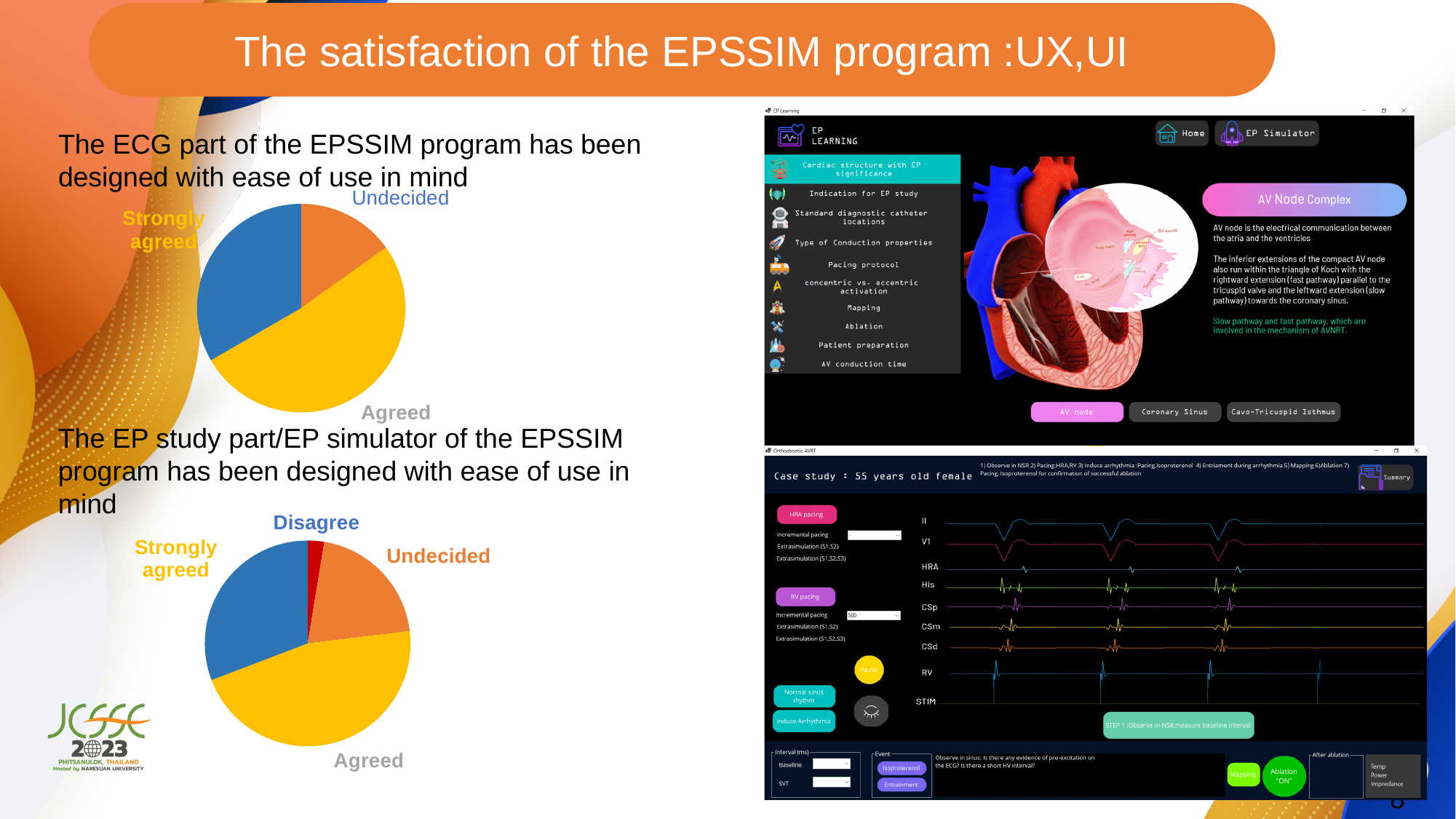
In the EP study part/EP simulator pie chart, which is larger: Undecided or Disagree? Undecided What kind of chart is used for the EP study part/EP simulator of the EPSSIM program? Pie chart In the ECG part pie chart, which response category has the smallest share? Undecided In the ECG part pie chart, which is larger: Strongly agreed or Undecided? Strongly agreed In the ECG part pie chart, which response category has the largest share? Agreed Which response category appears in the EP study part/EP simulator pie chart but not in the ECG part pie chart? Disagree In the EP study part/EP simulator pie chart, how many response categories are shown? 4 What kind of chart is used for the ECG part of the EPSSIM program? Pie chart In the EP study part/EP simulator pie chart, which response category has the smallest share? Disagree In the EP study part/EP simulator pie chart, which response category has the largest share? Agreed In the ECG part pie chart, how many response categories are shown? 3 In the ECG part pie chart, what colour is the Agreed slice? Yellow